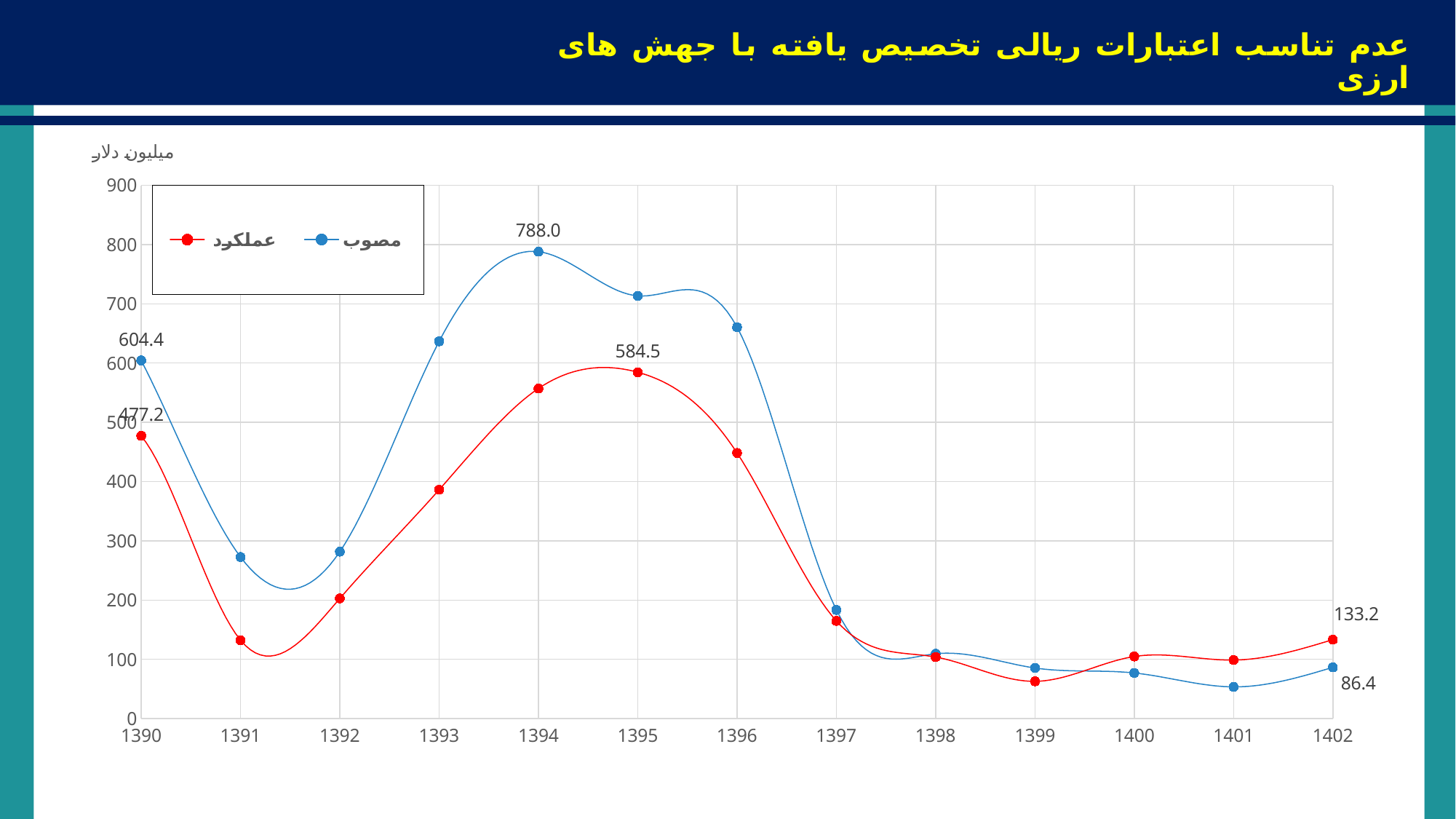
What is the difference between the مصوب and عملکرد values in 1390? 127.2 How many years are plotted along the x axis? 13 What is the value of the عملکرد series in 1395? 584.5 What is the value of the مصوب series in 1394? 788.0 What is the value of the مصوب series in 1390? 604.4 How many series does the legend list? 2 What type of chart is shown on the slide? line chart What is the value of the مصوب series in 1402? 86.4 In which year does the مصوب series reach its highest value? 1394 Is the value of the مصوب series in 1393 greater or less than 600? greater What is the value of the عملکرد series in 1390? 477.2 What is the value of the عملکرد series in 1402? 133.2